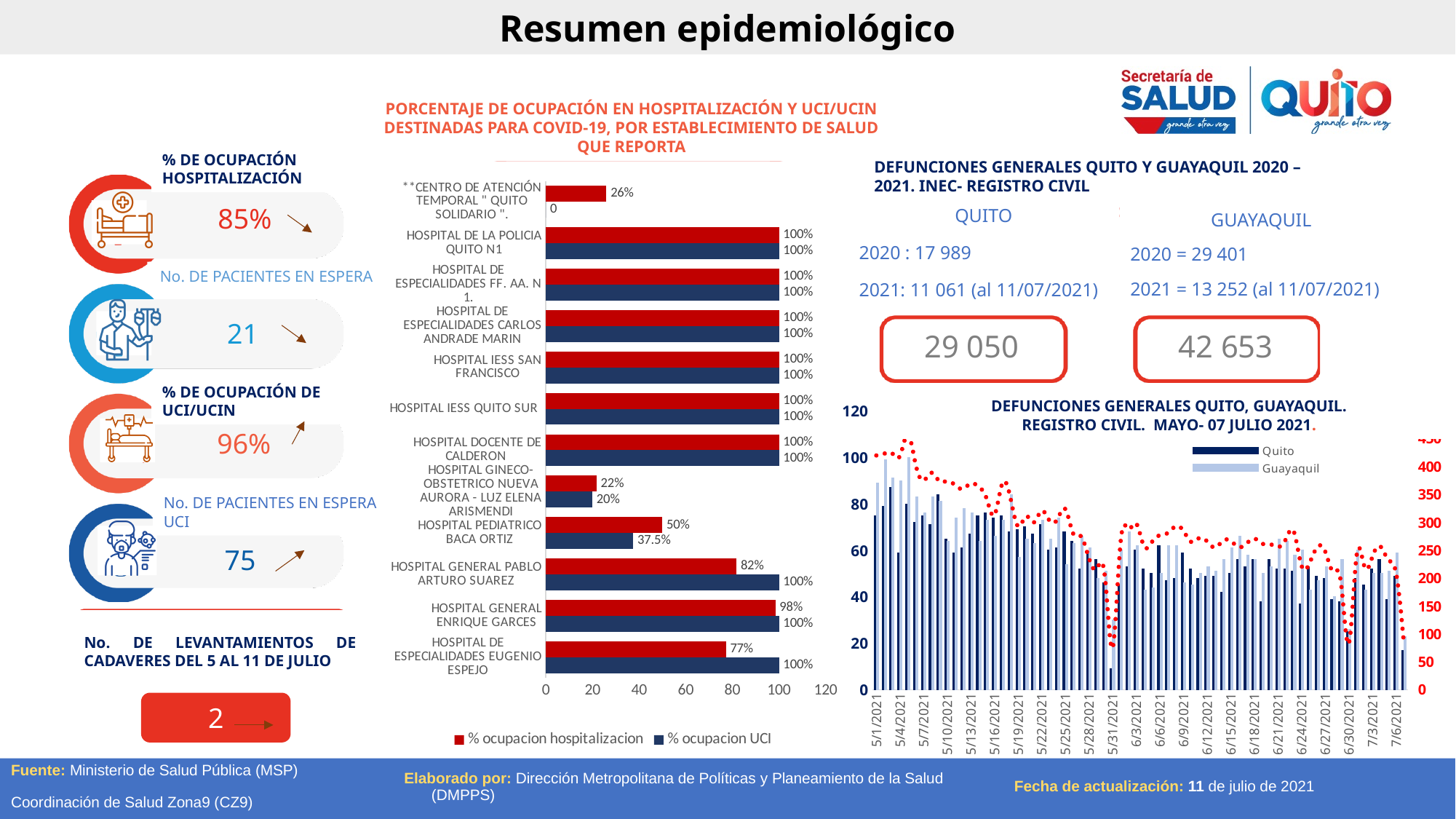
How many series does the legend of the chart 'PORCENTAJE DE OCUPACIÓN EN HOSPITALIZACIÓN Y UCI/UCIN' list? 2 In the chart 'PORCENTAJE DE OCUPACIÓN EN HOSPITALIZACIÓN Y UCI/UCIN', what is the difference between the % ocupacion UCI and the % ocupacion hospitalizacion for HOSPITAL GENERAL PABLO ARTURO SUAREZ? 18% In the chart 'PORCENTAJE DE OCUPACIÓN EN HOSPITALIZACIÓN Y UCI/UCIN', which is larger for HOSPITAL GINECO-OBSTETRICO NUEVA AURORA - LUZ ELENA ARISMENDI: % ocupacion hospitalizacion or % ocupacion UCI? % ocupacion hospitalizacion In the chart 'DEFUNCIONES GENERALES QUITO, GUAYAQUIL. REGISTRO CIVIL. MAYO- 07 JULIO 2021', which two series does the legend list? Quito and Guayaquil In the chart 'PORCENTAJE DE OCUPACIÓN EN HOSPITALIZACIÓN Y UCI/UCIN', what is the % ocupacion hospitalizacion for the CENTRO DE ATENCIÓN TEMPORAL 'QUITO SOLIDARIO'? 26% In the chart 'PORCENTAJE DE OCUPACIÓN EN HOSPITALIZACIÓN Y UCI/UCIN', which establishment has the lowest % ocupacion UCI? CENTRO DE ATENCIÓN TEMPORAL "QUITO SOLIDARIO" In the chart 'PORCENTAJE DE OCUPACIÓN EN HOSPITALIZACIÓN Y UCI/UCIN', what is the % ocupacion UCI for HOSPITAL PEDIATRICO BACA ORTIZ? 37.5% In the chart 'PORCENTAJE DE OCUPACIÓN EN HOSPITALIZACIÓN Y UCI/UCIN', what is the % ocupacion hospitalizacion for HOSPITAL DE ESPECIALIDADES EUGENIO ESPEJO? 77% How many establishments are listed in the chart 'PORCENTAJE DE OCUPACIÓN EN HOSPITALIZACIÓN Y UCI/UCIN'? 12 In the chart 'PORCENTAJE DE OCUPACIÓN EN HOSPITALIZACIÓN Y UCI/UCIN', what is the % ocupacion hospitalizacion for HOSPITAL GENERAL PABLO ARTURO SUAREZ? 82% In the chart 'PORCENTAJE DE OCUPACIÓN EN HOSPITALIZACIÓN Y UCI/UCIN', what is the % ocupacion hospitalizacion for HOSPITAL PEDIATRICO BACA ORTIZ? 50% What kind of chart is 'PORCENTAJE DE OCUPACIÓN EN HOSPITALIZACIÓN Y UCI/UCIN'? Bar chart